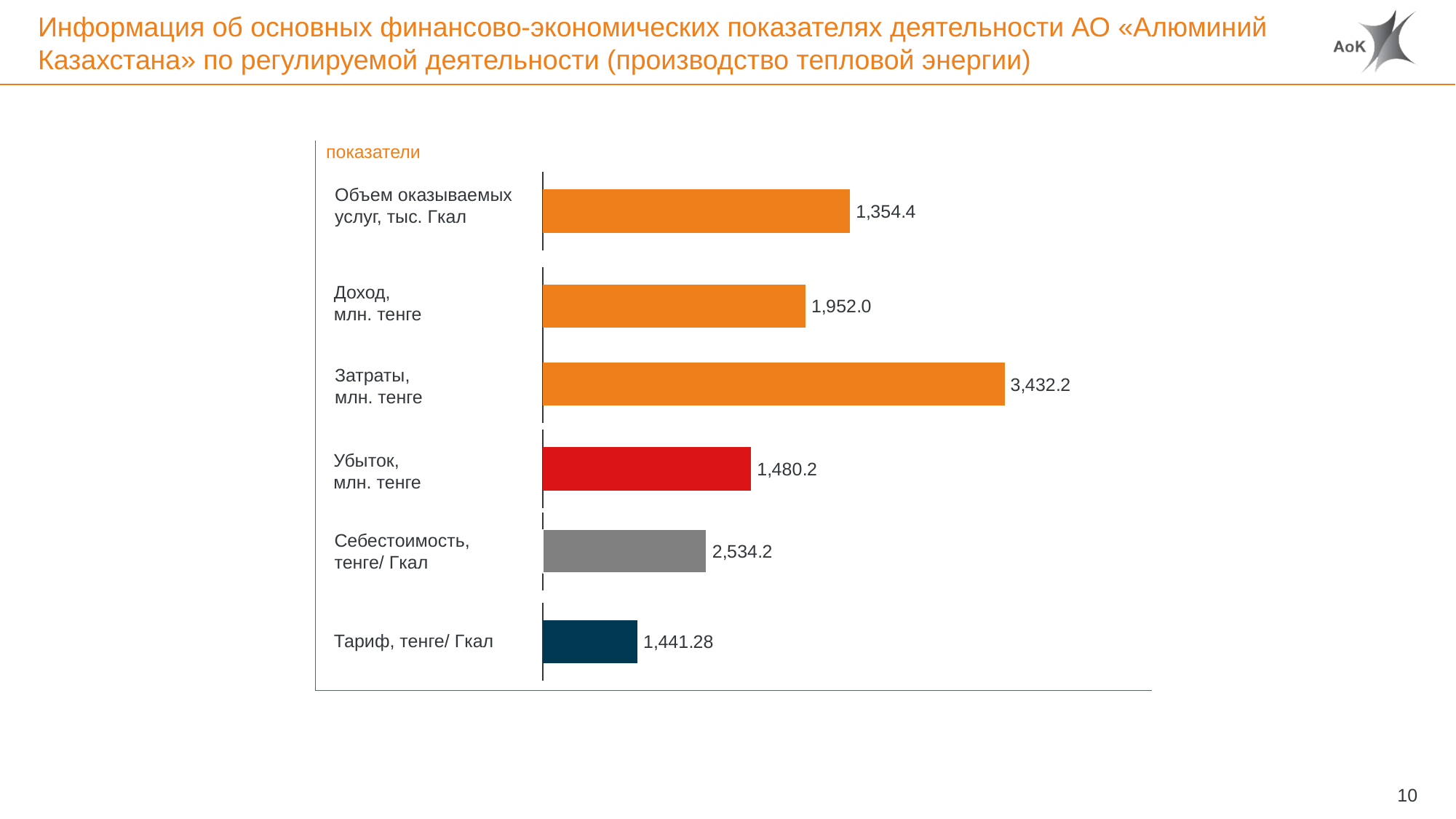
Which category has the longest bar in the chart? Затраты, млн. тенге What type of chart is shown on the slide? Bar chart Which is larger: the value for «Себестоимость, тенге/ Гкал» or the value for «Тариф, тенге/ Гкал»? Себестоимость, тенге/ Гкал What is the difference between «Затраты, млн. тенге» and «Доход, млн. тенге»? 1,480.2 What is the value shown for «Объем оказываемых услуг, тыс. Гкал»? 1,354.4 What is the value shown for «Доход, млн. тенге»? 1,952.0 What is the value shown for «Тариф, тенге/ Гкал»? 1,441.28 Which category has the shortest bar in the chart? Тариф, тенге/ Гкал What colour is the bar for «Убыток, млн. тенге»? Red How many categories are plotted in the chart? 6 What is the value shown for «Затраты, млн. тенге»? 3,432.2 What is the value shown for «Себестоимость, тенге/ Гкал»? 2,534.2